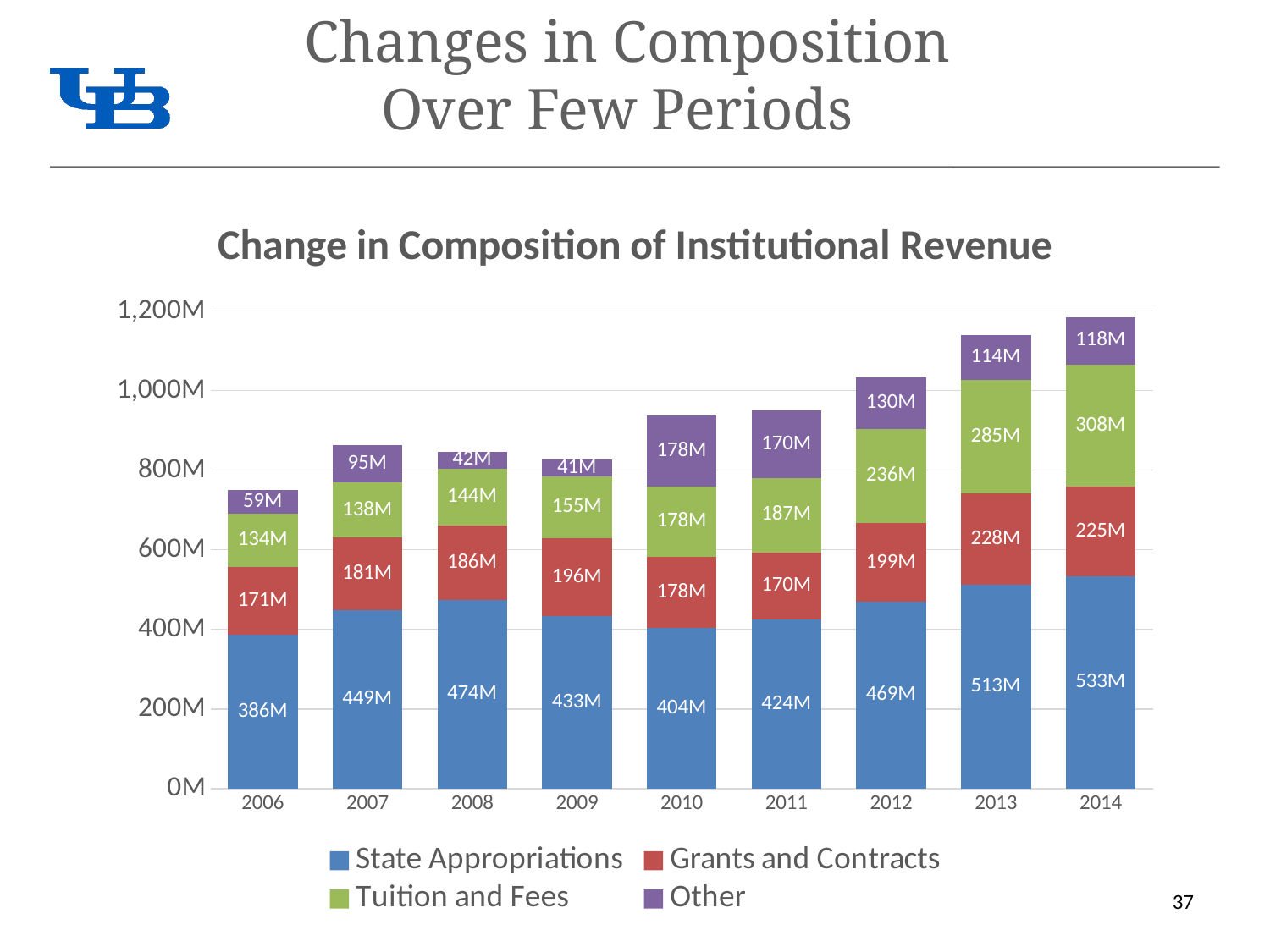
What is the value for Other in 2007? 95M In which year is State Appropriations lowest? 2006 What is the value for State Appropriations in 2014? 533M What is the total of the stacked bar for 2006? 750M How many years are shown on the x axis? 9 How many series does the legend list? 4 In which year is State Appropriations highest? 2014 What kind of chart is shown? Stacked bar chart What is the difference between Grants and Contracts in 2013 and in 2006? 57M Is the total height of the 2012 bar greater or less than 1,000M? greater What is the value for Tuition and Fees in 2012? 236M In 2014, which is larger: Tuition and Fees or Grants and Contracts? Tuition and Fees